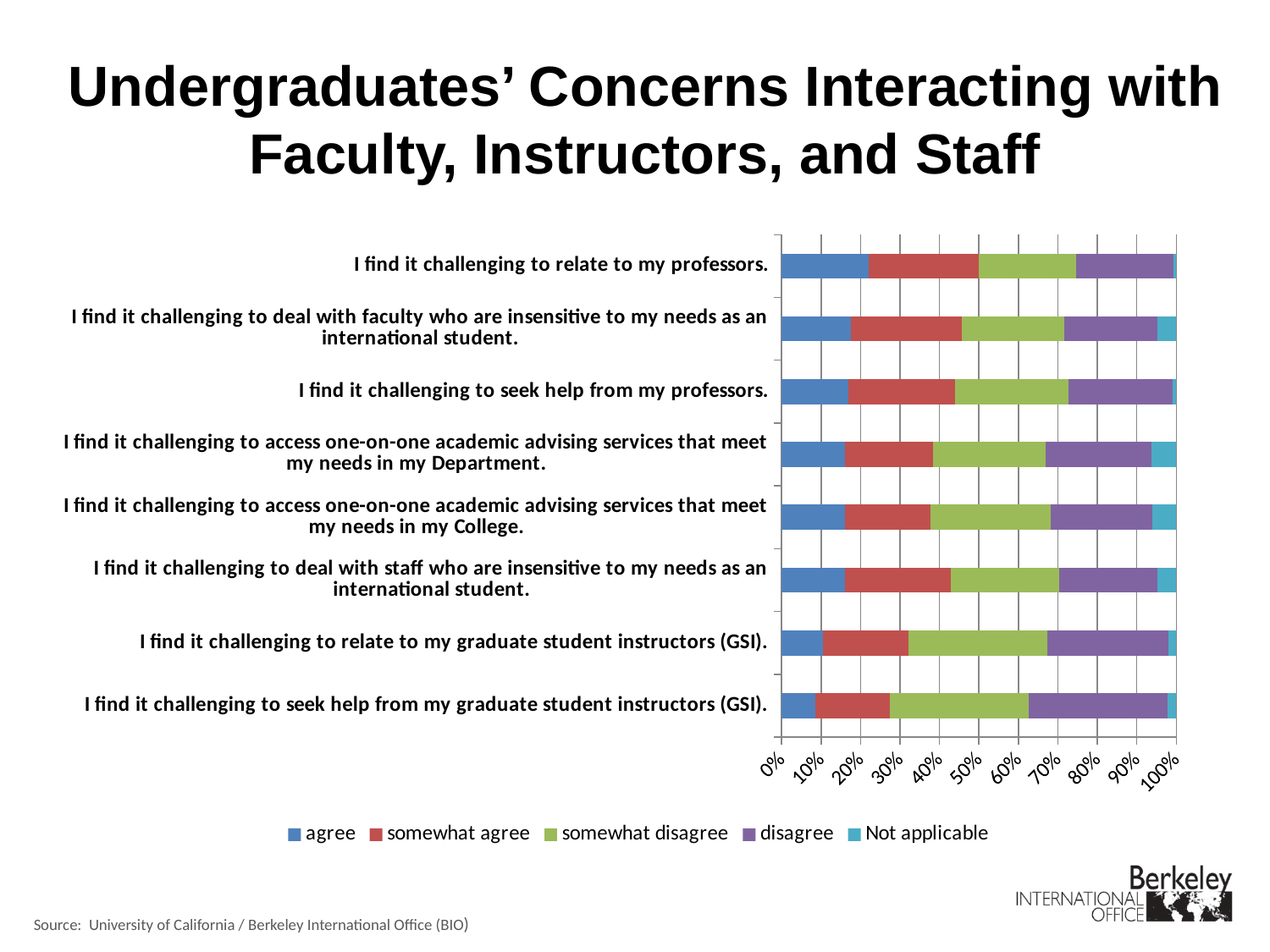
Is the 'agree' segment for 'I find it challenging to relate to my professors.' greater or less than 10%? greater What kind of chart is shown on the slide? bar chart Is the 'agree' segment for 'I find it challenging to seek help from my graduate student instructors (GSI).' greater or less than 20%? less What is the title of the slide containing the chart? Undergraduates' Concerns Interacting with Faculty, Instructors, and Staff Is the 'disagree' segment for 'I find it challenging to seek help from my graduate student instructors (GSI).' greater or less than 30%? greater Which statement has the largest 'agree' segment? I find it challenging to relate to my professors. What is the first entry listed in the chart legend? agree How many statements (categories) are plotted in the chart? 8 How many series does the legend list? 5 Which has a larger 'agree' segment: 'I find it challenging to relate to my professors.' or 'I find it challenging to relate to my graduate student instructors (GSI).'? I find it challenging to relate to my professors.